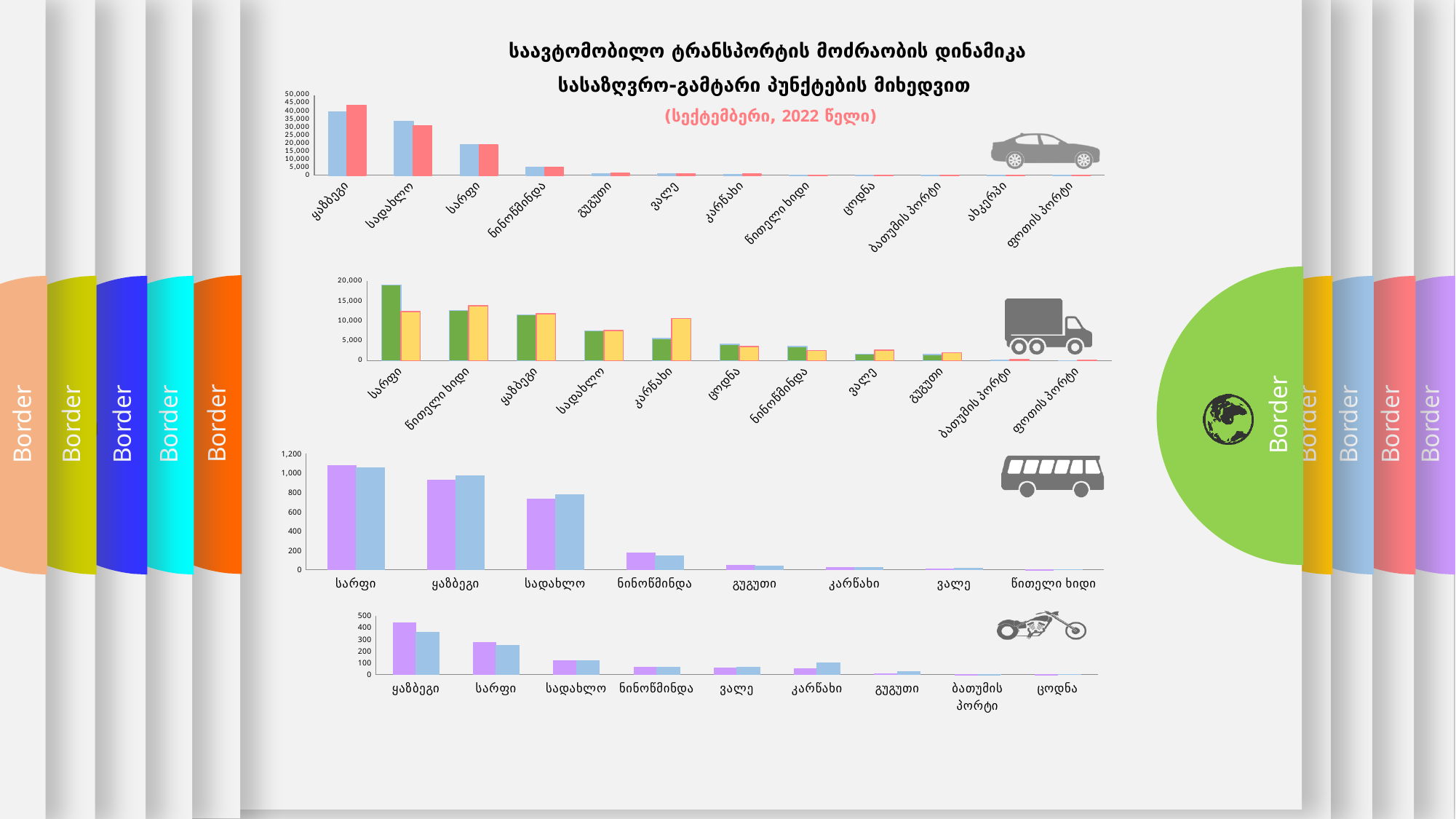
In the top chart (with the car icon), which category has the highest bars? ყაზბეგი What period is given in the subtitle of the slide, shown in red under the title? (სექტემბერი, 2022 წელი) How many categories are shown on the x axis of the second chart (with the truck icon)? 11 In the second chart (with the truck icon), which category has the tallest bar? სარფი In the second chart (with the truck icon), is the green bar for სარფი greater or less than 15,000? greater How many categories are shown on the x axis of the top chart (with the car icon)? 12 In the third chart (with the bus icon), do the values generally rise or fall from left to right along the x axis? fall In the fourth chart (with the motorcycle icon), are the values for სადახლო greater or less than 200? less How many categories are shown on the x axis of the third chart (with the bus icon)? 8 In the second chart (with the truck icon), for კარწახი, which bar is larger, the green one or the yellow one? the yellow one In the top chart (with the car icon), are the values for სარფი greater or less than 25,000? less What kind of chart is the top chart on the slide (with the car icon)? bar chart